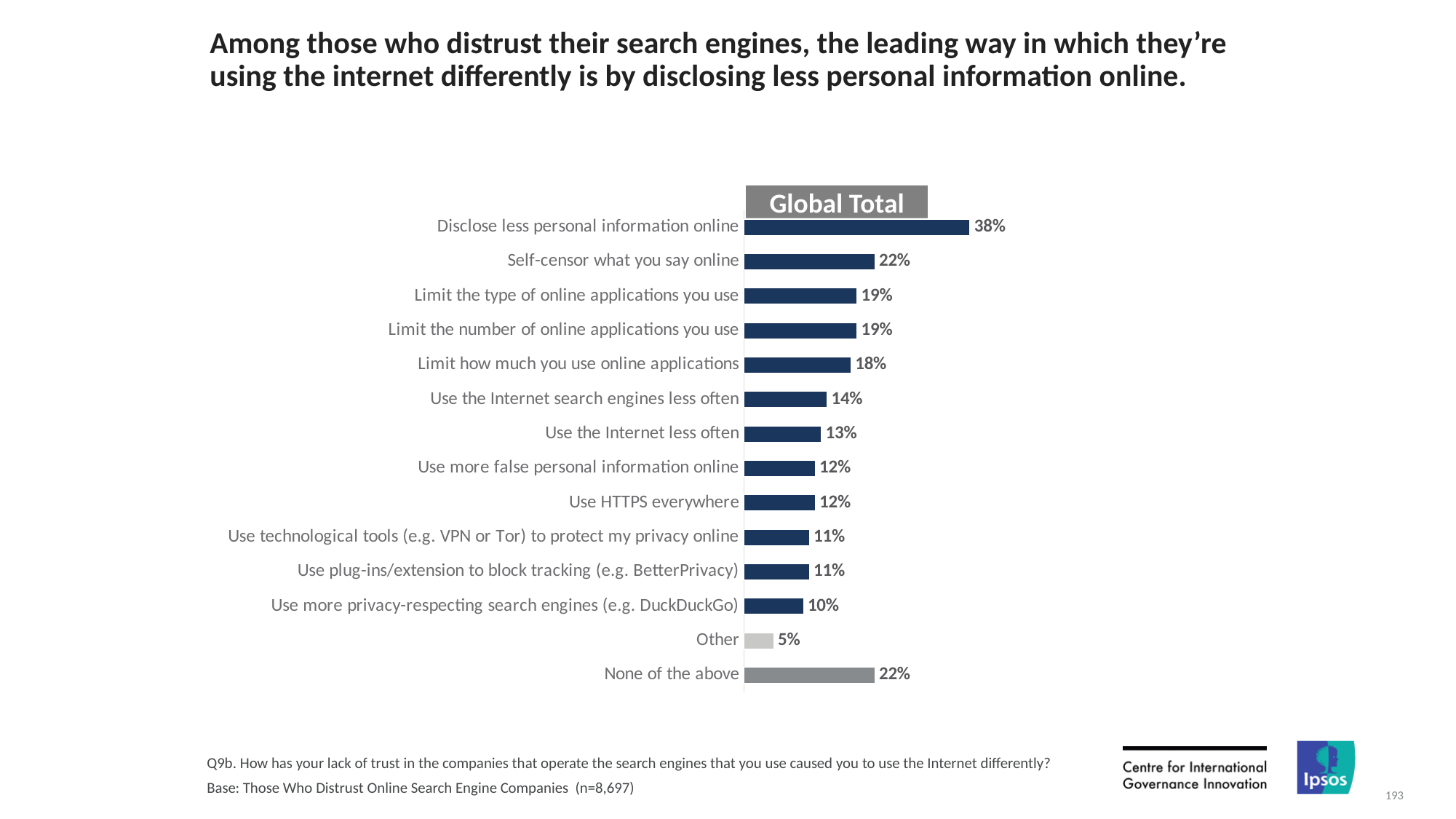
Which is larger: "Limit how much you use online applications" or "Use the Internet less often"? Limit how much you use online applications What is the difference between "Use the Internet search engines less often" and "Use the Internet less often"? 1% What is the value for "Other"? 5% What is the label shown in the grey box above the bars? Global Total How many categories are shown in the chart? 14 What is the value for "Disclose less personal information online"? 38% Which category has the highest value? Disclose less personal information online What kind of chart is shown on the slide? Bar chart What is the difference between "Disclose less personal information online" and "Self-censor what you say online"? 16% What is the value for "Use more privacy-respecting search engines (e.g. DuckDuckGo)"? 10% Which category has the lowest value? Other What is the value for "Use HTTPS everywhere"? 12%